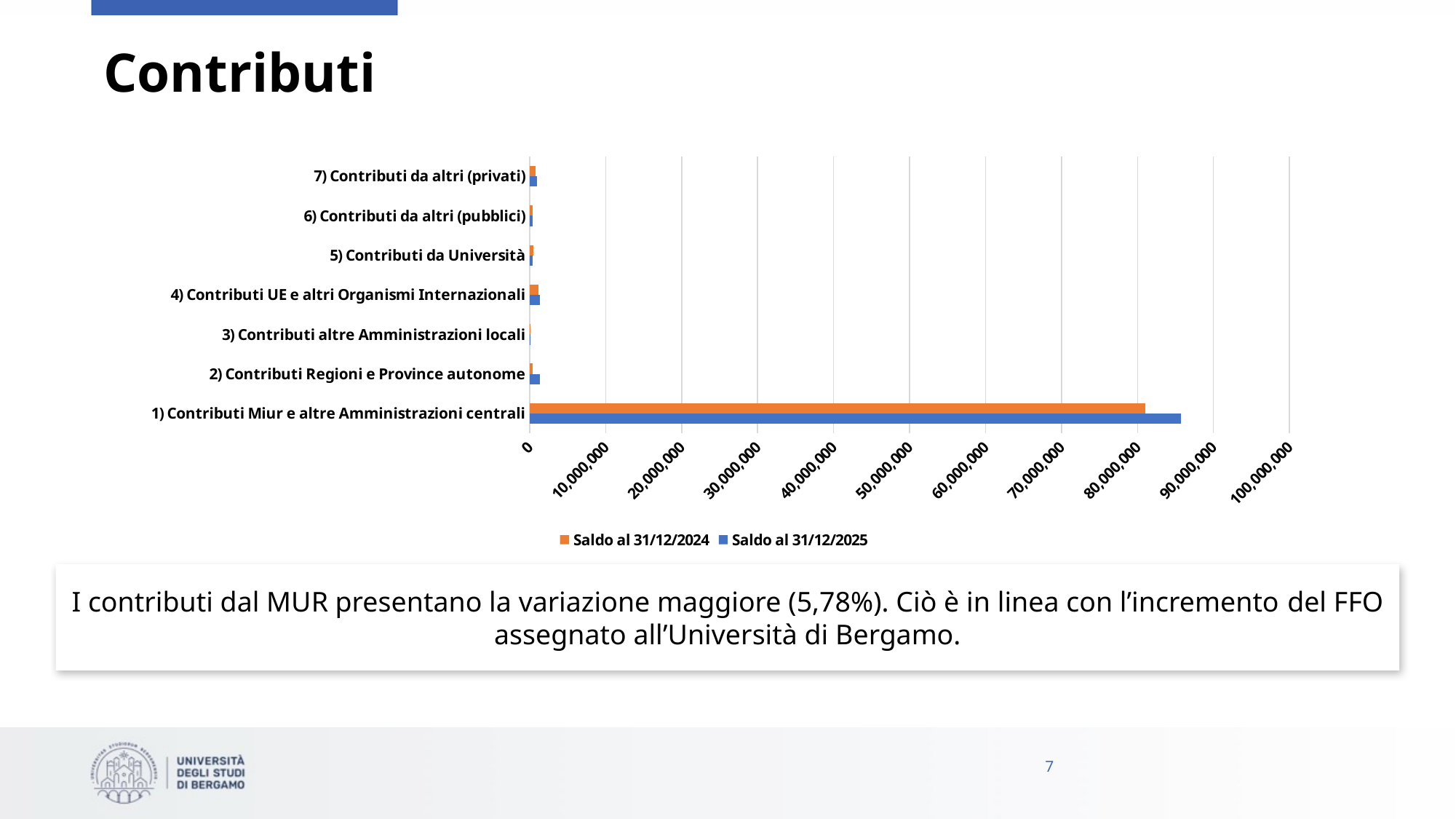
Which category has the highest value for Saldo al 31/12/2025? 1) Contributi Miur e altre Amministrazioni centrali Which category has the lowest values in the chart? 3) Contributi altre Amministrazioni locali Is the Saldo al 31/12/2025 value for 1) Contributi Miur e altre Amministrazioni centrali greater or less than 90,000,000? less What kind of chart is shown on the slide? bar chart Is the Saldo al 31/12/2024 value for 1) Contributi Miur e altre Amministrazioni centrali greater or less than 90,000,000? less For 2) Contributi Regioni e Province autonome, which is larger: Saldo al 31/12/2024 or Saldo al 31/12/2025? Saldo al 31/12/2025 What are the two series named in the chart legend? Saldo al 31/12/2024 and Saldo al 31/12/2025 Is the Saldo al 31/12/2025 value for 1) Contributi Miur e altre Amministrazioni centrali greater or less than 80,000,000? greater How many series does the chart legend list? 2 Which category has the highest value for Saldo al 31/12/2024? 1) Contributi Miur e altre Amministrazioni centrali How many categories of contributi are plotted in the chart? 7 For 1) Contributi Miur e altre Amministrazioni centrali, which is larger: Saldo al 31/12/2024 or Saldo al 31/12/2025? Saldo al 31/12/2025